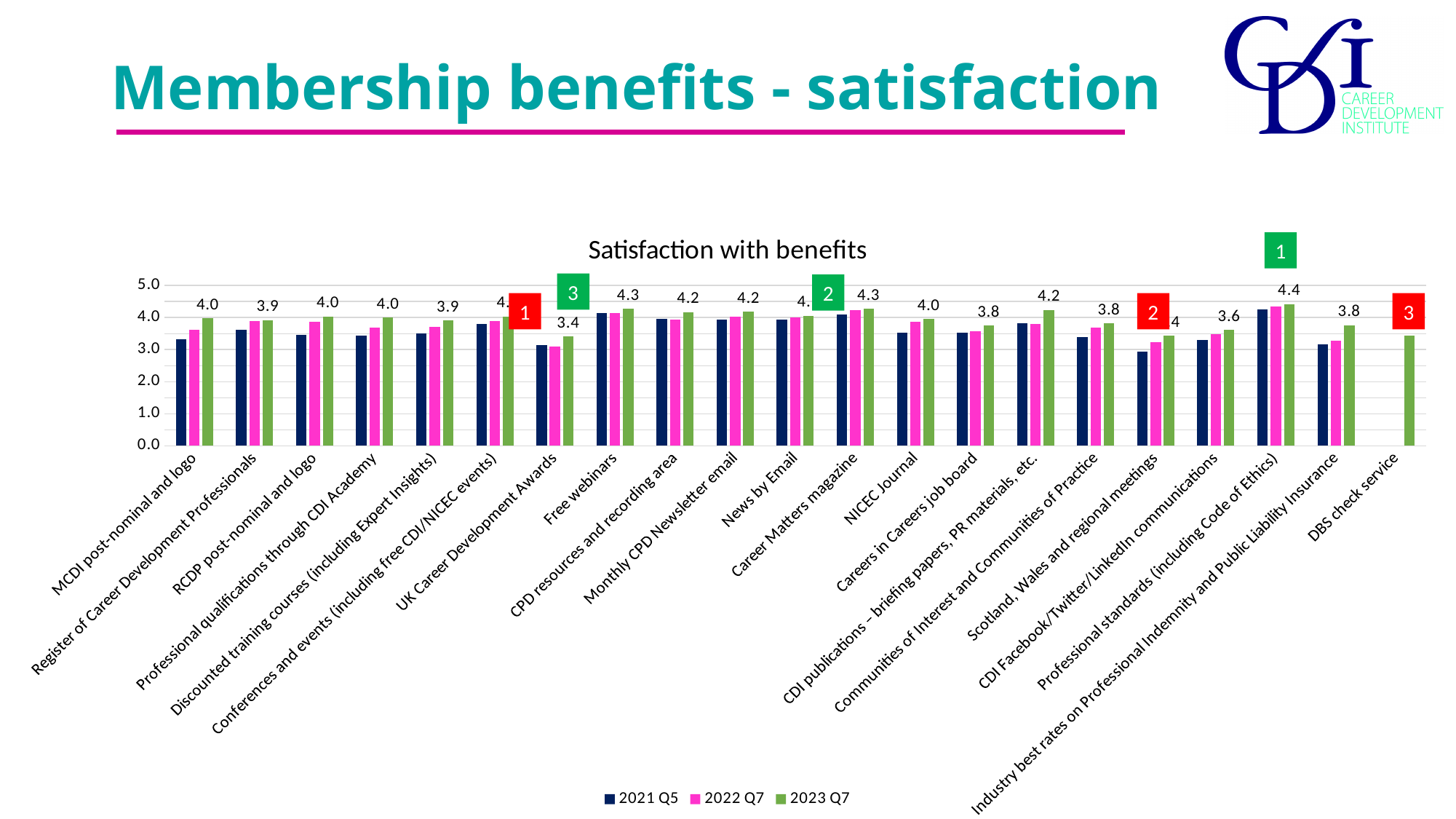
What kind of chart is shown on the slide? Bar chart Is the 2022 Q7 value for Professional standards (including Code of Ethics) greater or less than 4.0? greater Which has the larger 2023 Q7 value: Free webinars or NICEC Journal? Free webinars What is the title of the chart? Satisfaction with benefits How many series does the legend list? 3 What is the 2023 Q7 satisfaction value for Professional standards (including Code of Ethics)? 4.4 What is the difference between the 2023 Q7 values for Professional standards (including Code of Ethics) and UK Career Development Awards? 1.0 How many benefit categories are shown on the x axis? 21 Which category has the highest 2023 Q7 satisfaction value? Professional standards (including Code of Ethics) What is the 2023 Q7 satisfaction value for Free webinars? 4.3 Which series are listed in the legend? 2021 Q5, 2022 Q7, 2023 Q7 What is the 2023 Q7 satisfaction value for CDI Facebook/Twitter/LinkedIn communications? 3.6